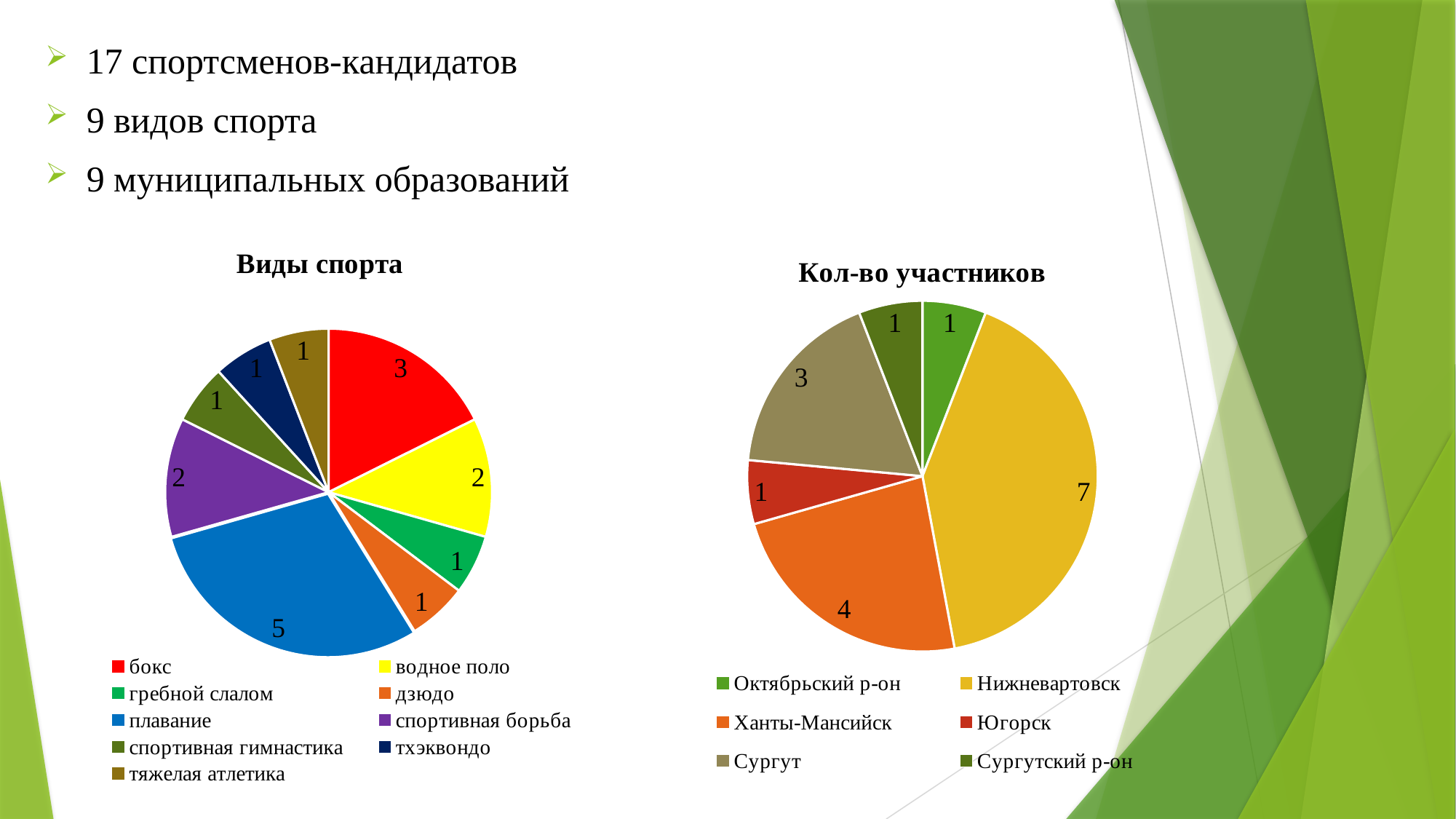
What type of chart is 'Виды спорта'? pie chart In the 'Виды спорта' chart, what is the difference between the values for плавание and водное поло? 3 In the 'Виды спорта' chart, which is larger, бокс or спортивная борьба? бокс How many categories does the 'Виды спорта' chart show? 9 In the 'Кол-во участников' chart, what is the value for Ханты-Мансийск? 4 In the 'Кол-во участников' chart, what is the value for Нижневартовск? 7 In the 'Кол-во участников' chart, what is the difference between the values for Нижневартовск and Сургут? 4 In the 'Кол-во участников' chart, which municipality has the largest slice? Нижневартовск In the 'Виды спорта' chart, what is the value for плавание? 5 In the 'Виды спорта' chart, which sport has the largest slice? плавание How many categories does the 'Кол-во участников' chart show? 6 In the 'Виды спорта' chart, what is the value for бокс? 3